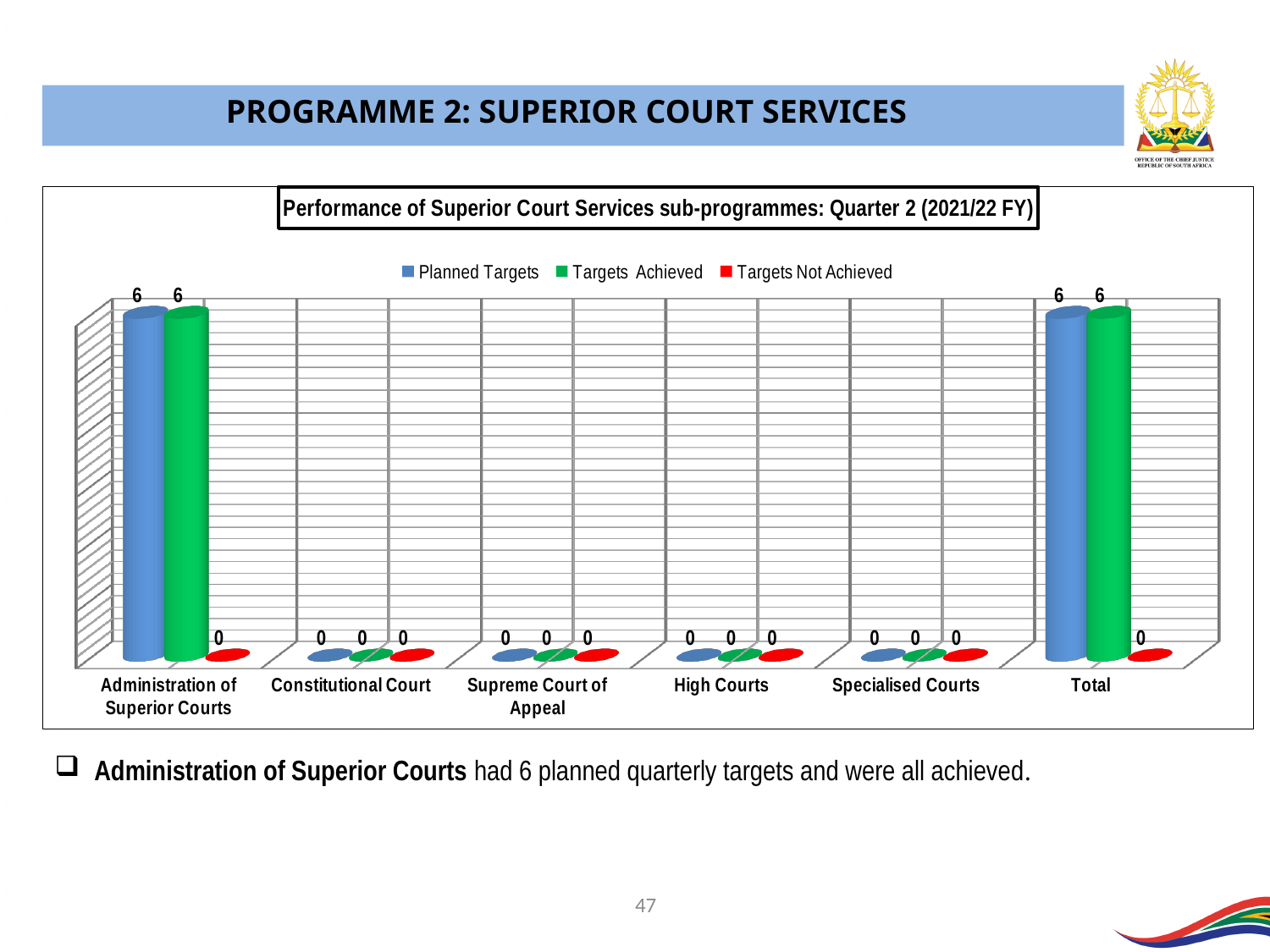
What is the Planned Targets value for Constitutional Court? 0 Which category other than Total has the highest Planned Targets value? Administration of Superior Courts Which colour represents Targets Not Achieved in the legend? Red How many categories are shown on the x axis? 6 What is the Targets Achieved value for Total? 6 What is the difference between Planned Targets and Targets Achieved for Administration of Superior Courts? 0 What kind of chart is shown? Bar chart What is the Planned Targets value for Administration of Superior Courts? 6 What is the Targets Not Achieved value for High Courts? 0 Is the Planned Targets value for Administration of Superior Courts larger than the Planned Targets value for Specialised Courts? Yes How many series does the legend list? 3 What is the title of the chart? Performance of Superior Court Services sub-programmes: Quarter 2 (2021/22 FY)